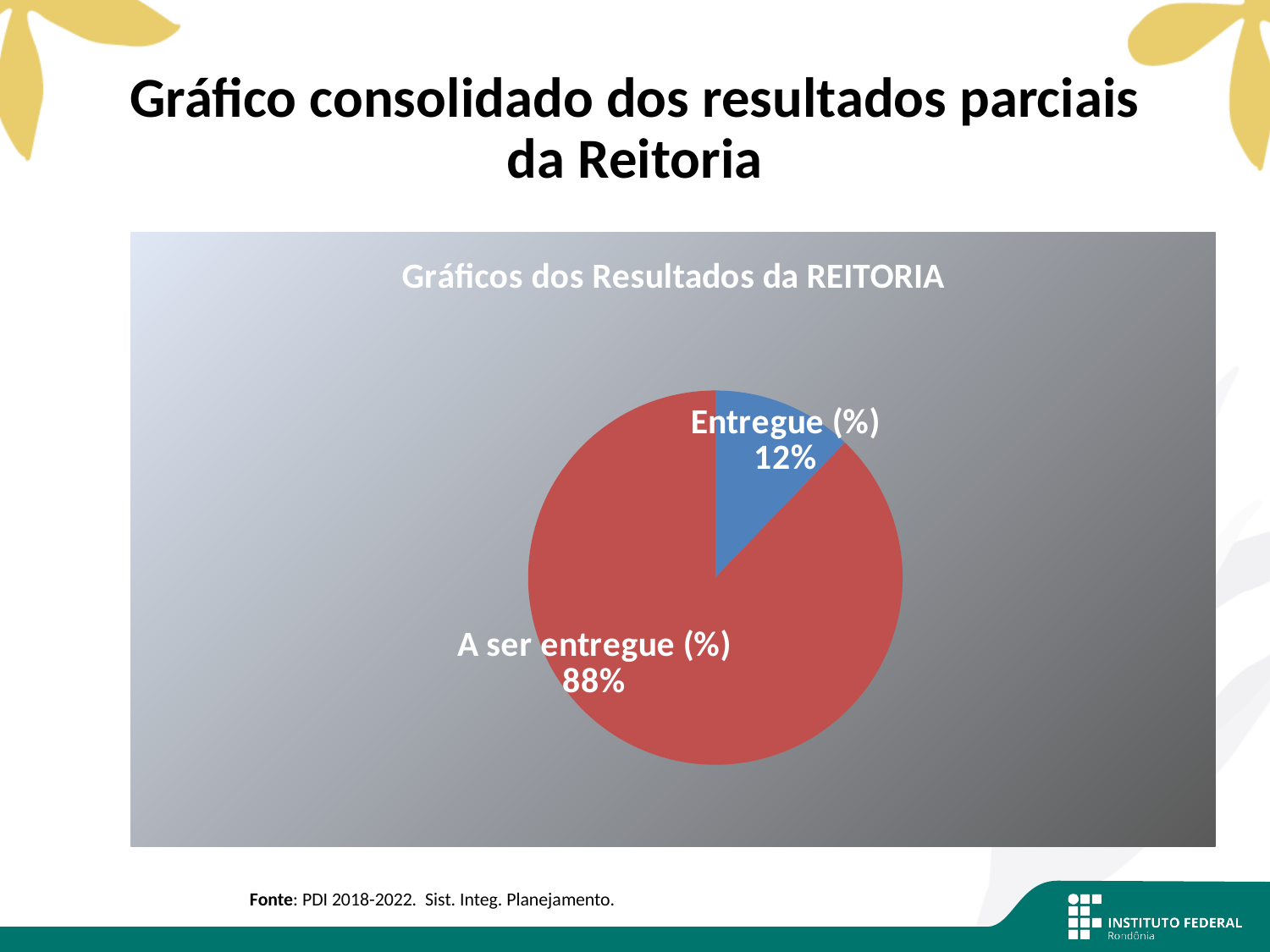
What is the value for A ser entregue (%)? 88% What is the difference between A ser entregue (%) and Entregue (%)? 76% What kind of chart is shown on the slide? pie chart Which is larger, Entregue (%) or A ser entregue (%)? A ser entregue (%) What colour is the A ser entregue (%) slice? red What share of the pie does Entregue (%) represent? 12% How many slices does the pie chart have? 2 Which slice is the largest? A ser entregue (%) What is the title of the chart? Gráficos dos Resultados da REITORIA What is the value for Entregue (%)? 12% Which slice is the smallest? Entregue (%)